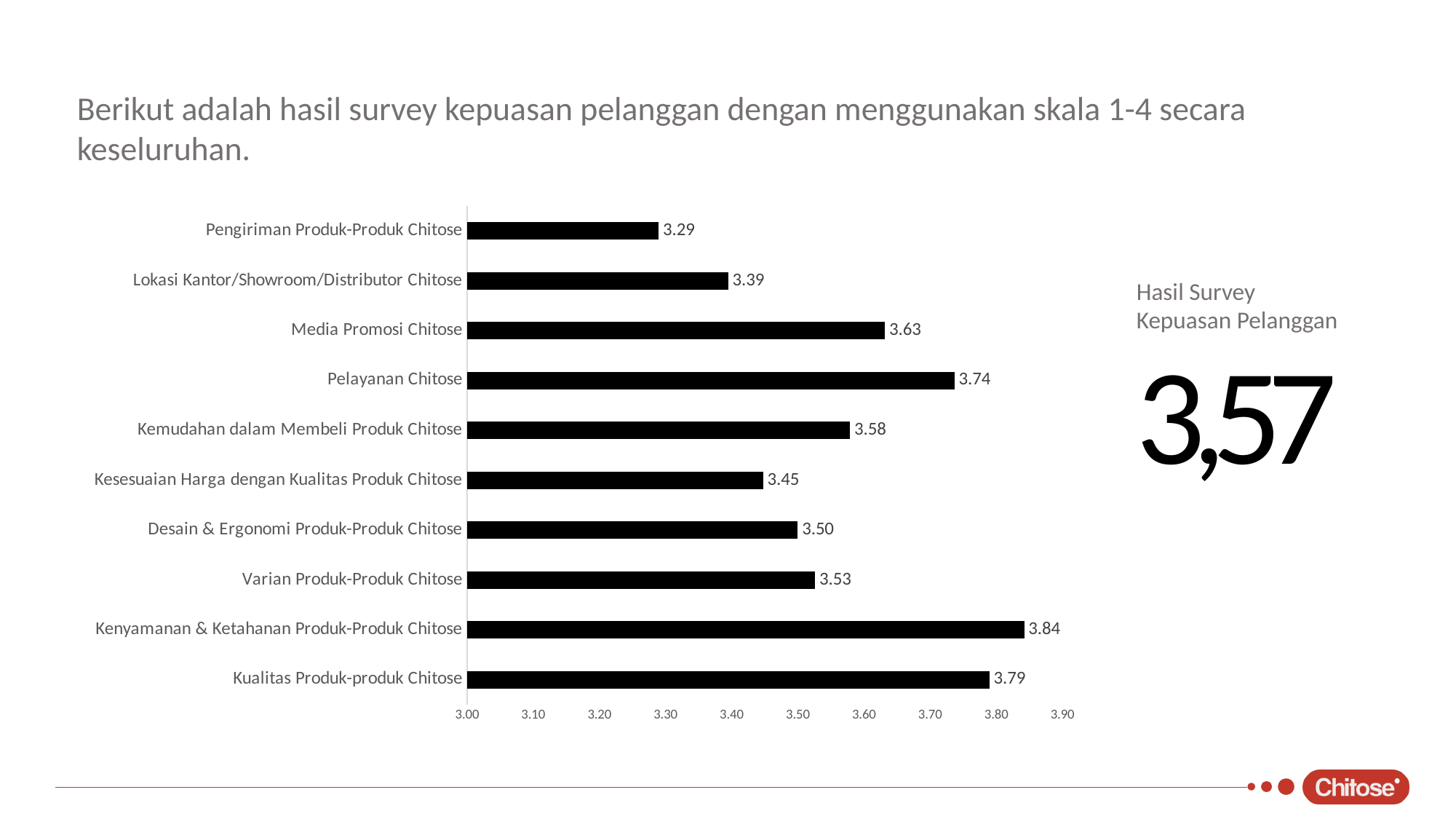
What is the value for Kesesuaian Harga dengan Kualitas Produk Chitose? 3.45 What is the difference between the values for Kualitas Produk-produk Chitose and Pengiriman Produk-Produk Chitose? 0.50 Is the value for Lokasi Kantor/Showroom/Distributor Chitose greater or less than 3.50? less What is the value for Media Promosi Chitose? 3.63 What is the value for Pelayanan Chitose? 3.74 Which category has the highest value? Kenyamanan & Ketahanan Produk-Produk Chitose What kind of chart is shown on the slide? bar chart What overall customer satisfaction survey result is shown to the right of the chart? 3,57 Which category has the lowest value? Pengiriman Produk-Produk Chitose How many categories are shown in the chart? 10 Which is larger, the value for Varian Produk-Produk Chitose or Desain & Ergonomi Produk-Produk Chitose? Varian Produk-Produk Chitose What is the difference between the values for Kenyamanan & Ketahanan Produk-Produk Chitose and Kemudahan dalam Membeli Produk Chitose? 0.26